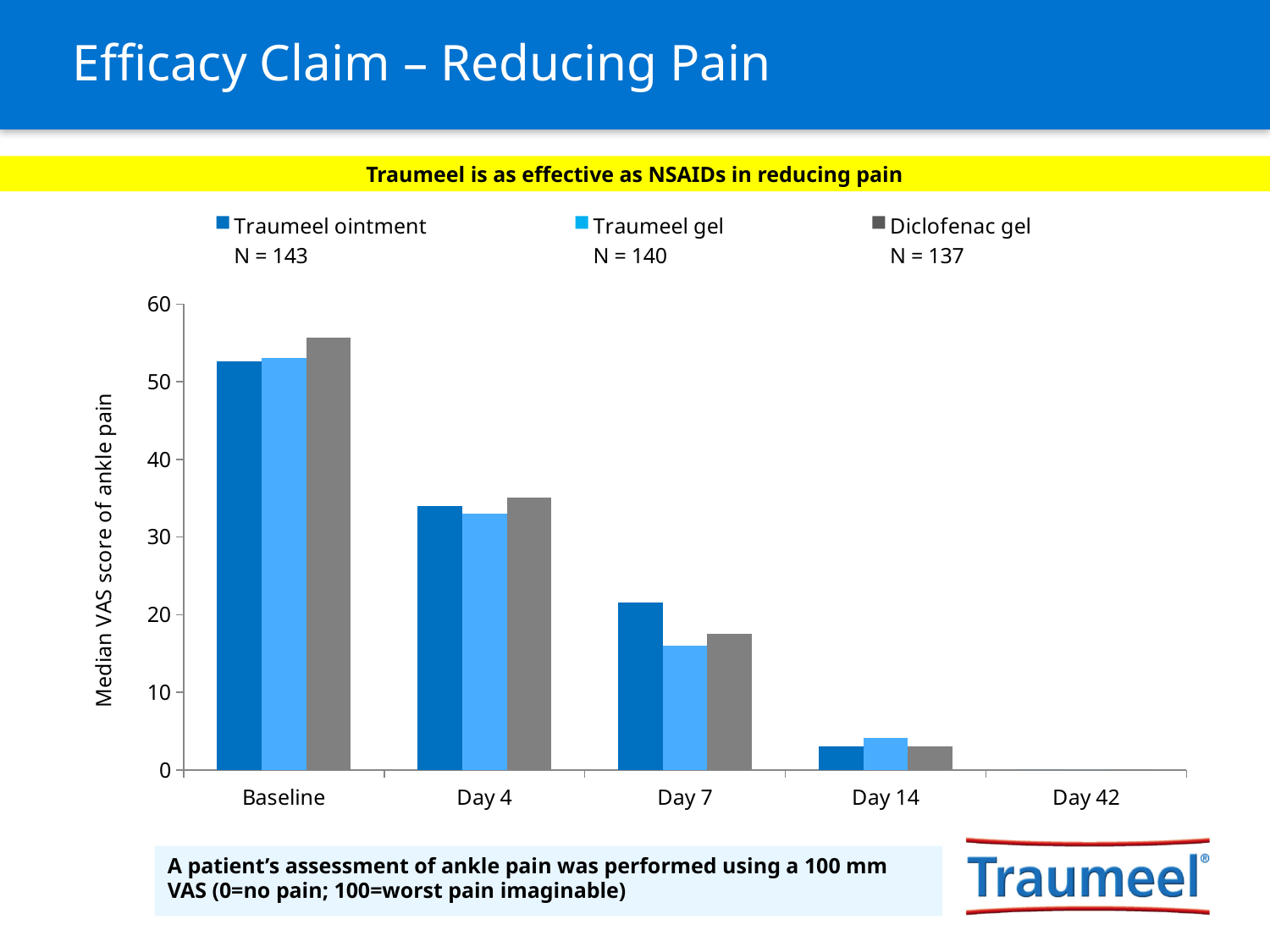
Which series has the highest value at Day 7? Traumeel ointment Is the value for Diclofenac gel at Day 4 greater or less than 40? less What is the N shown in the legend for Traumeel gel? N = 140 For Traumeel ointment, which is larger: the value at Baseline or at Day 4? Baseline Is the value for Traumeel gel at Day 7 greater or less than 20? less How many series does the legend list? 3 Is the value for Traumeel ointment at Baseline greater or less than 50? greater How many time-point categories are shown on the x axis? 5 At which time point is the Diclofenac gel value highest? Baseline Do the median VAS scores rise or fall from Baseline to Day 14? fall What kind of chart is shown on the slide? bar chart